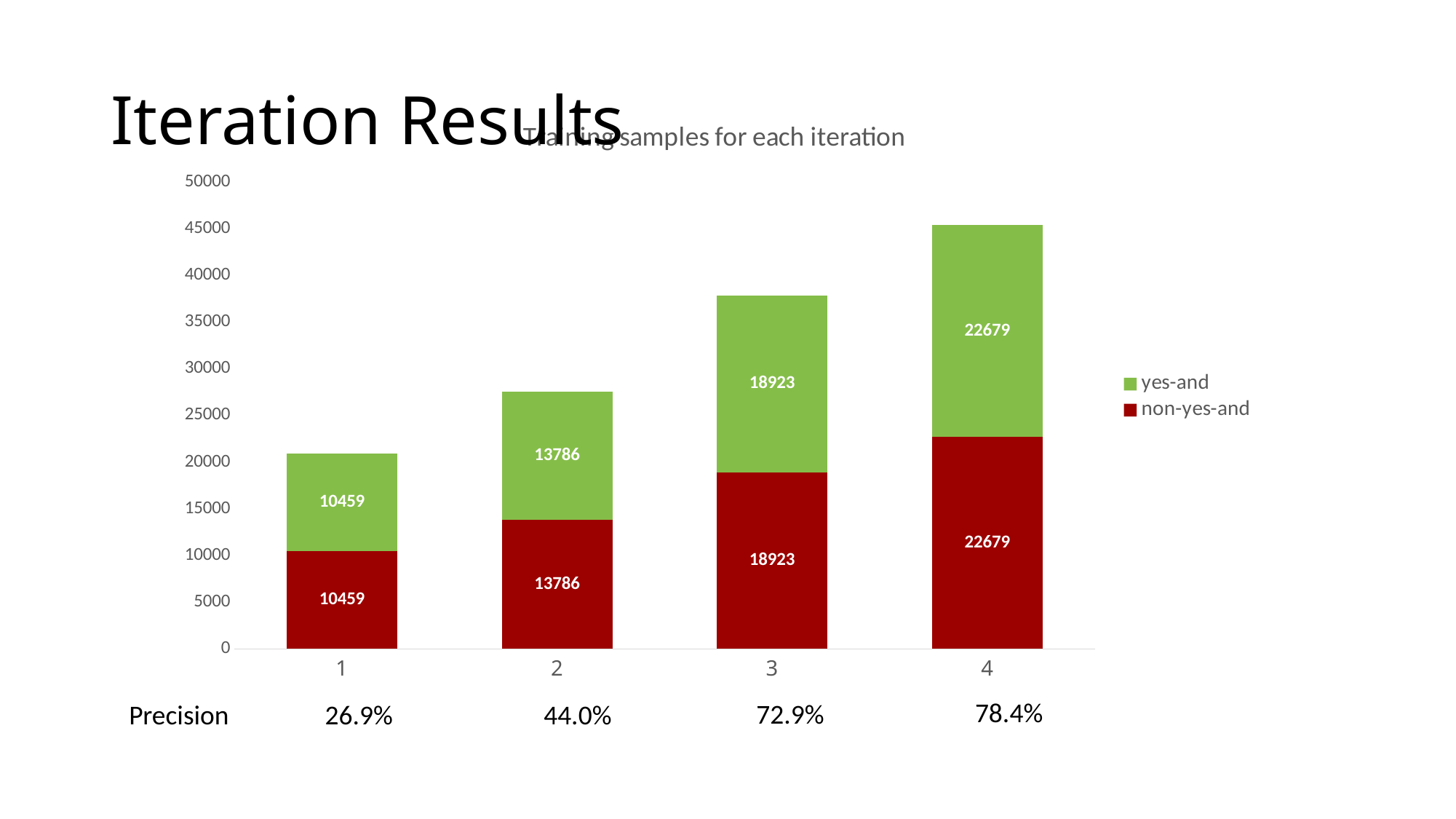
How many iterations are shown on the x axis? 4 What is the yes-and value for iteration 3? 18923 How many series does the legend list? 2 What kind of chart is shown? stacked bar chart What is the total height of the stacked bar for iteration 4? 45358 What is the yes-and value for iteration 1? 10459 What is the total height of the stacked bar for iteration 1? 20918 Which is larger, the non-yes-and value for iteration 3 or for iteration 2? iteration 3 Which iteration has the lowest yes-and value? 1 Which iteration has the highest non-yes-and value? 4 What is the difference between the yes-and values for iteration 4 and iteration 1? 12220 What is the non-yes-and value for iteration 2? 13786